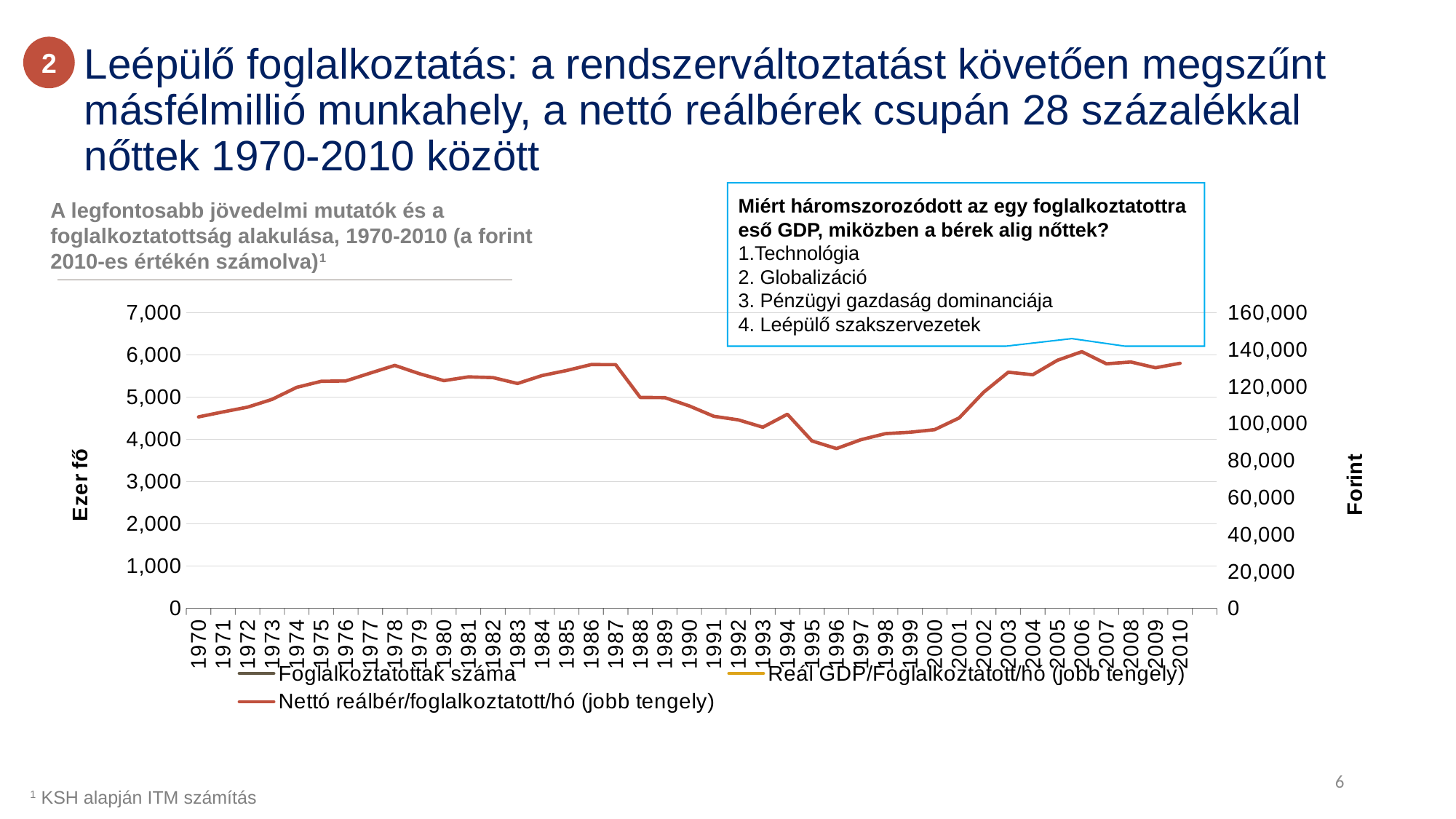
Does the red line in the chart rise or fall between 1996 and 2006? Rise What kind of chart is shown on the slide? Line chart Which series in the legend is labelled as plotted on the right axis and refers to net real wages? Nettó reálbér/foglalkoztatott/hó (jobb tengely) What is the last year shown on the x axis of the chart? 2010 Does the red line in the chart rise or fall between 1970 and 1978? Rise What is the highest tick value on the left-hand axis of the chart? 7,000 What is the highest tick value on the right-hand axis of the chart? 160,000 How many series does the chart legend list? 3 Does the red line in the chart rise or fall between 1987 and 1996? Fall What is the first year shown on the x axis of the chart? 1970 How many years are plotted along the x axis of the chart? 41